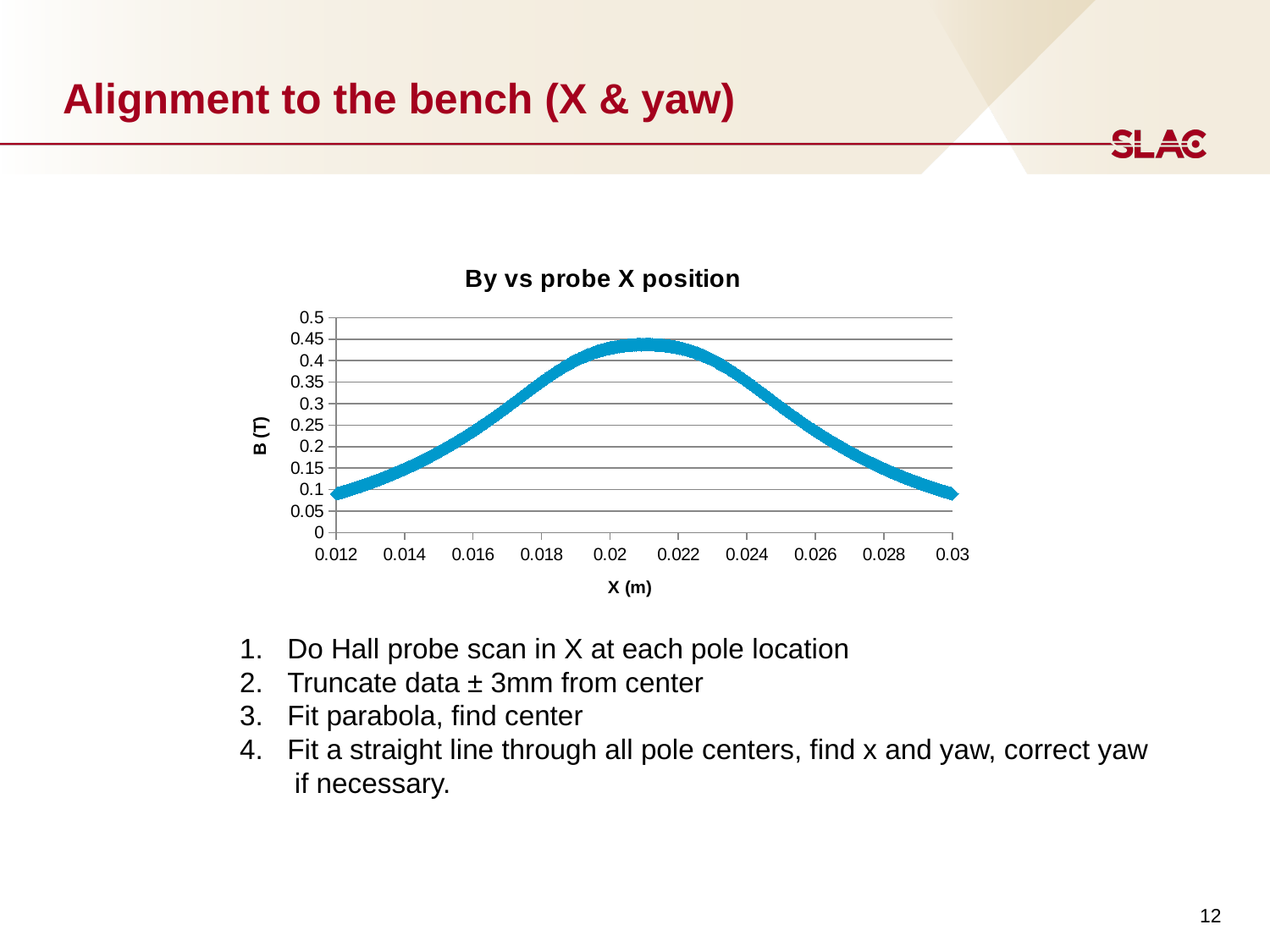
Is the value of B at X = 0.018 m greater or less than 0.25? greater What is the label of the y axis of the chart? B (T) Is the value of B at X = 0.028 m greater or less than 0.2? less Is the value of B at X = 0.02 m greater or less than 0.35? greater Does B rise or fall as X increases from 0.022 m to 0.03 m? fall Which has the larger value of B: X = 0.014 m or X = 0.02 m? 0.02 Which has the larger value of B: X = 0.018 m or X = 0.028 m? 0.018 Does B rise or fall as X increases from 0.012 m to 0.02 m? rise What is the title of the chart? By vs probe X position